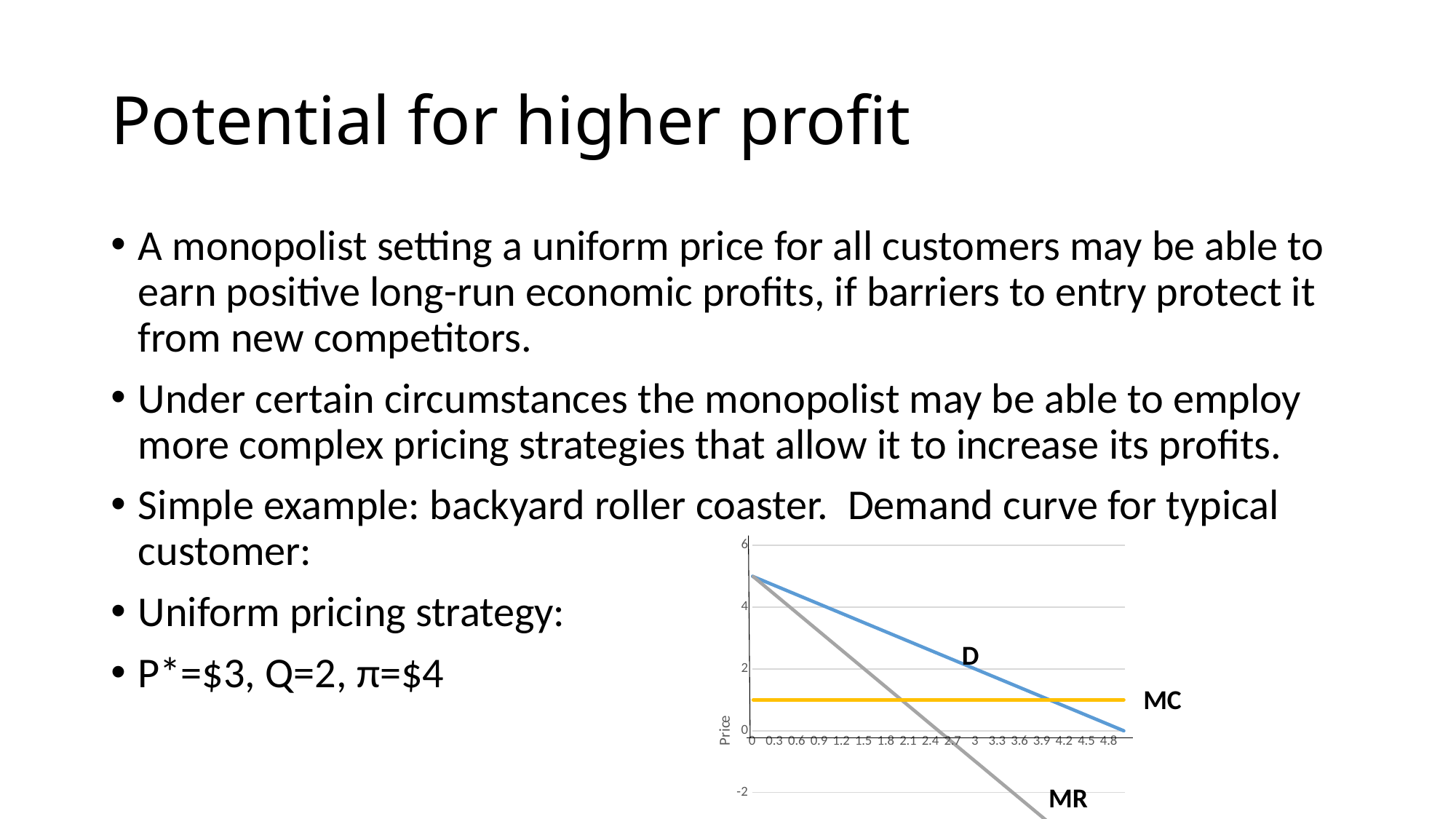
Does the MR line rise or fall as quantity increases along the x axis? fall At quantity 3.9, which line is lowest on the chart? MR What kind of chart is shown on the slide? line chart What is the label of the vertical axis of the chart? Price Is the value of the MC line greater or less than 2? less Does the D line rise or fall as quantity increases along the x axis? fall Which line on the chart is horizontal (flat)? MC Is the value of the MR line at quantity 3 greater or less than 0? less Is the value of the D line at quantity 0 greater or less than 4? greater How many lines are plotted on the chart? 3 At quantity 3, which line is higher, D or MR? D